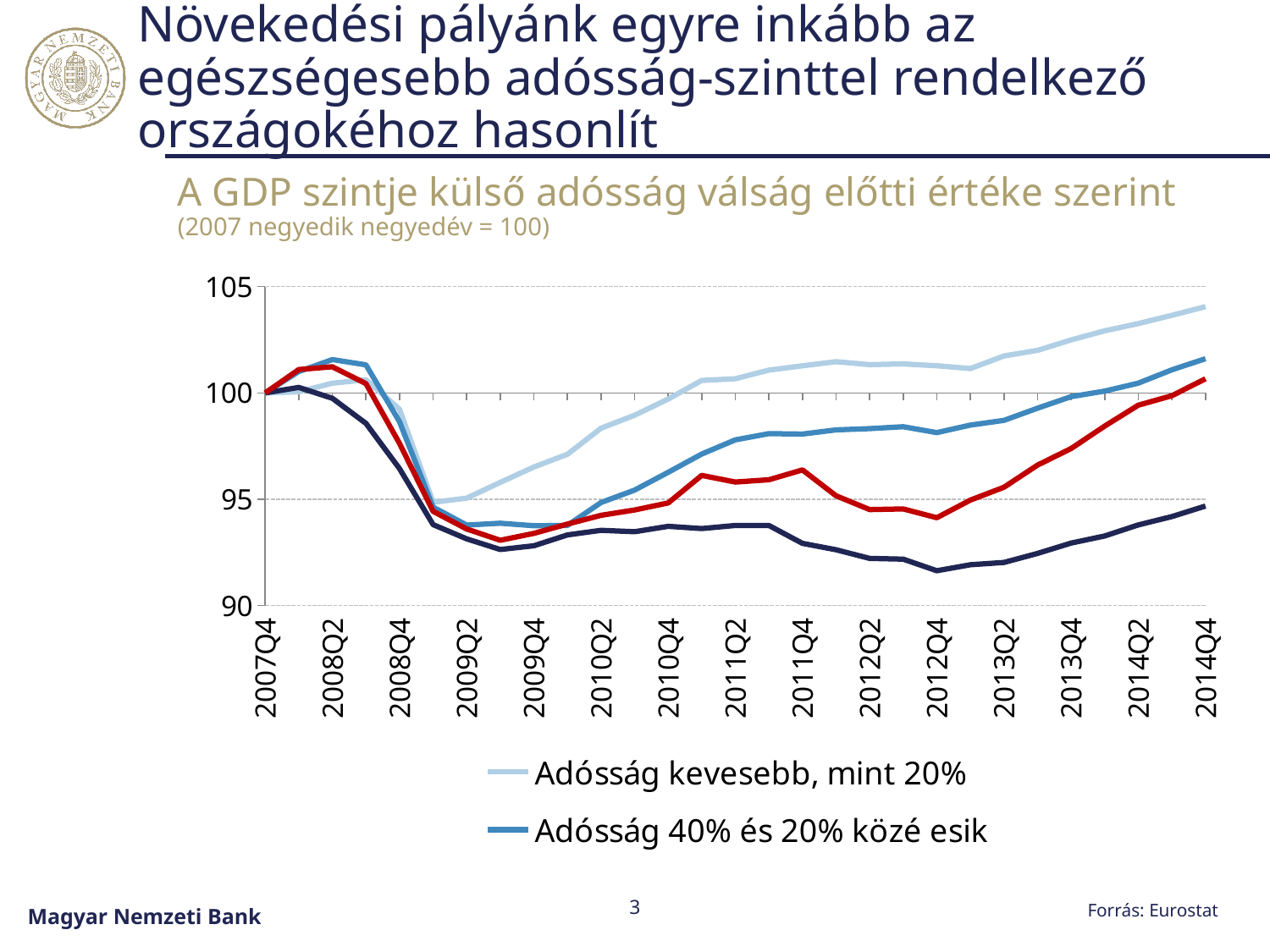
Is the value for 'Adósság kevesebb, mint 20%' at 2009Q2 greater or less than 100? less How many quarter labels are shown on the x axis? 15 What kind of chart is shown on the slide? line chart Does the 'Adósság kevesebb, mint 20%' series rise or fall between 2012Q4 and 2014Q4? rise Is the value for 'Adósság kevesebb, mint 20%' at 2014Q4 greater or less than 100? greater Is the value for 'Adósság 40% és 20% közé esik' at 2014Q4 greater or less than 100? greater How many series does the chart's legend list? 2 What is the source given for the chart? Eurostat At 2014Q4, which series is higher: 'Adósság kevesebb, mint 20%' or 'Adósság 40% és 20% közé esik'? Adósság kevesebb, mint 20% What is the title of the chart? A GDP szintje külső adósság válság előtti értéke szerint What is the value of the series at 2007Q4, the base period of the index? 100